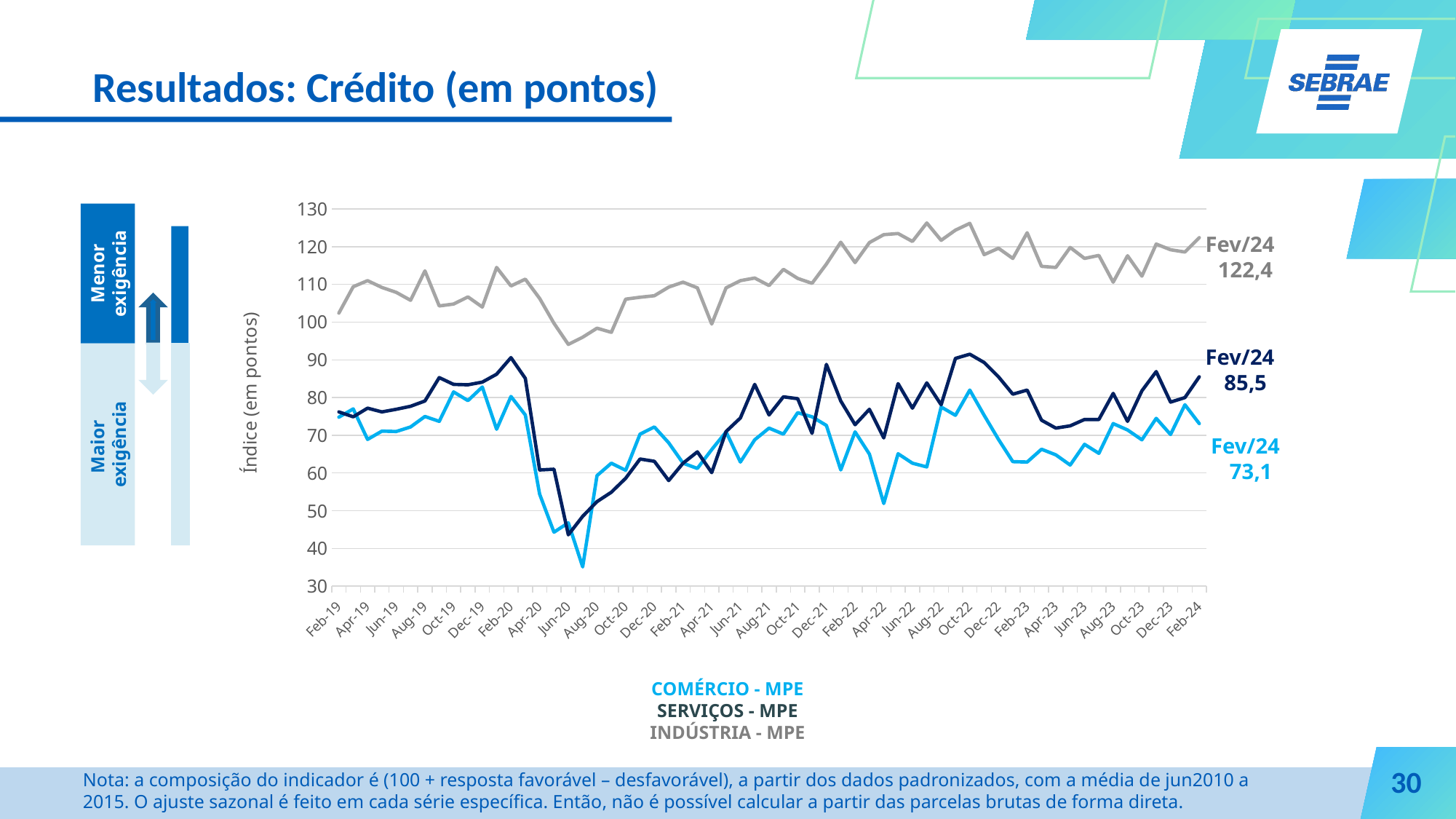
What is the difference between the Fev/24 values of INDÚSTRIA - MPE and SERVIÇOS - MPE? 36,9 What kind of chart is shown on the slide? Line chart What is the value of SERVIÇOS - MPE in Fev/24? 85,5 Is the lowest value of COMÉRCIO - MPE greater or less than 40? less In Fev/24, which is larger: SERVIÇOS - MPE or COMÉRCIO - MPE? SERVIÇOS - MPE What is the value of INDÚSTRIA - MPE in Fev/24? 122,4 What is the label of the vertical axis? Índice (em pontos) What is the value of COMÉRCIO - MPE in Fev/24? 73,1 How many series does the legend list? 3 Which series has the lowest value in Fev/24? COMÉRCIO - MPE What is the difference between the Fev/24 values of SERVIÇOS - MPE and COMÉRCIO - MPE? 12,4 Which series has the highest value in Fev/24? INDÚSTRIA - MPE